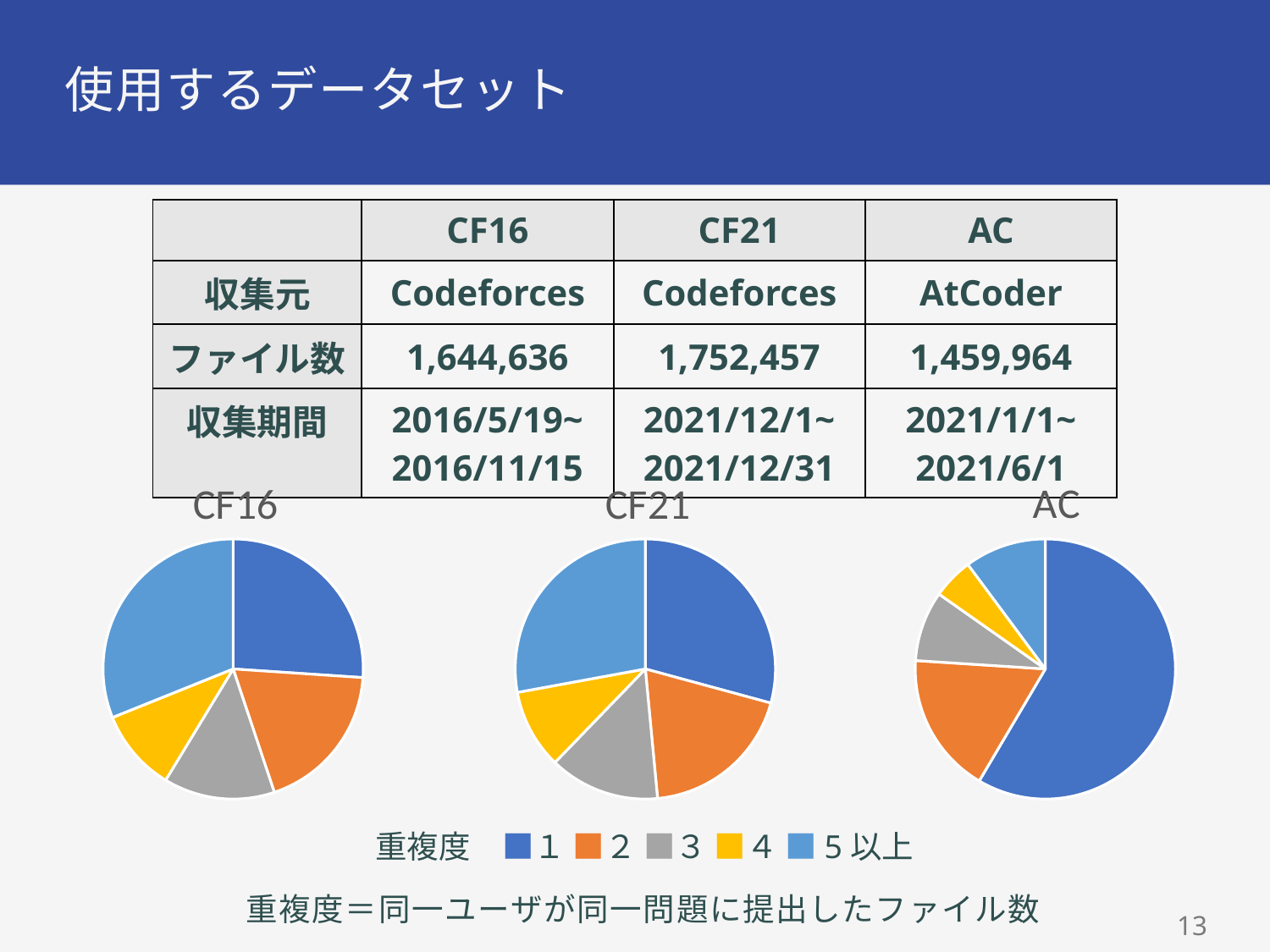
In the CF16 pie chart, which slice is larger: 2 or 4? 2 In the CF16 pie chart, which category has the smallest slice? 4 In the AC pie chart, does the slice for 1 take up more or less than half of the pie? more What is the title of the legend shared by the three pie charts? 重複度 What kind of chart is the CF16 chart? pie chart In the AC pie chart, which category has the smallest slice? 4 How many slices does the CF16 pie chart have? 5 In the AC pie chart, which category has the largest slice? 1 In the CF21 pie chart, which slice is larger: 1 or 4? 1 In the CF16 pie chart, which category has the largest slice? 5 以上 In the AC pie chart, which slice is larger: 1 or 2? 1 How many entries does the legend list for the pie charts? 5